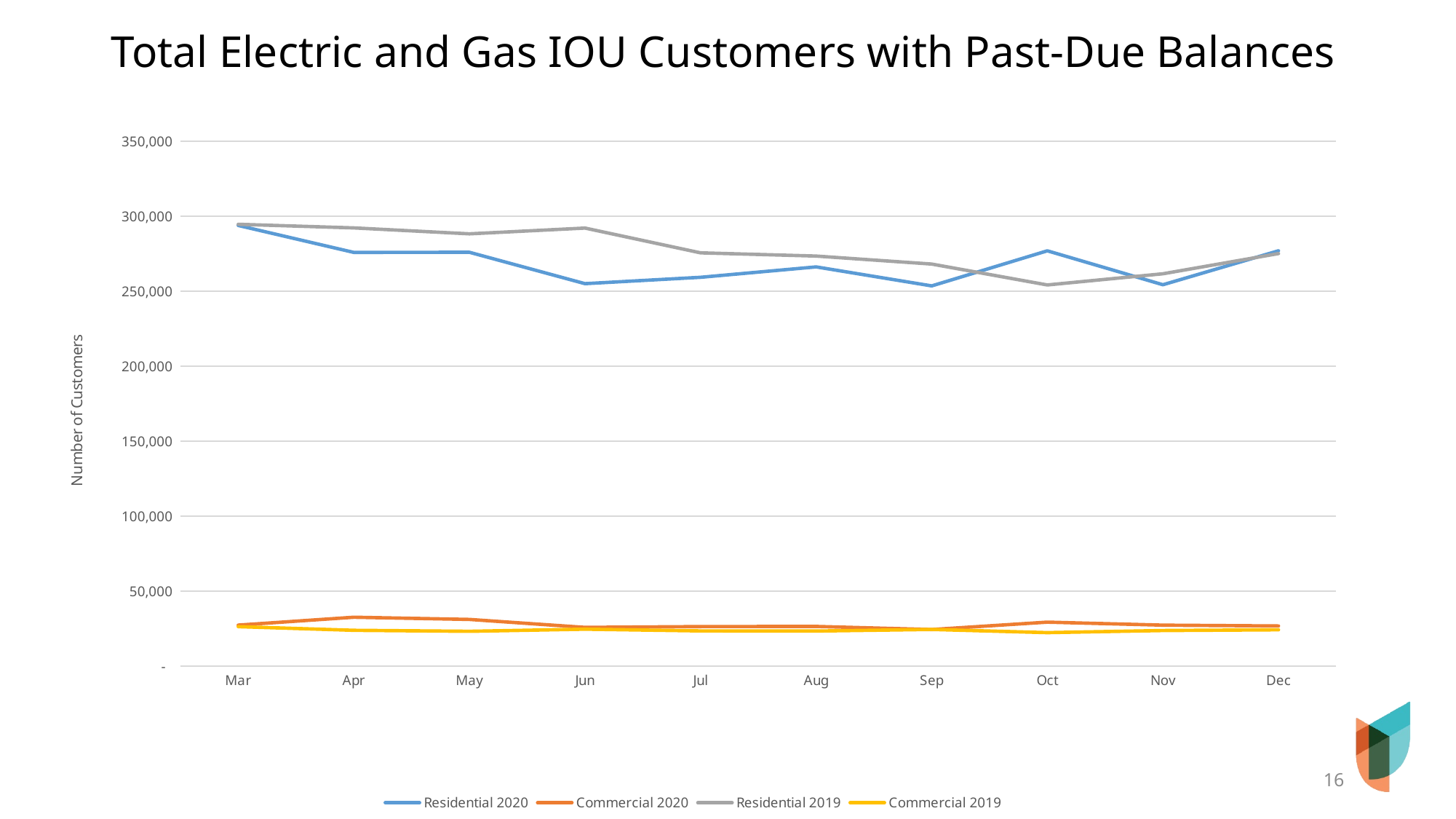
Is the value for Residential 2020 in Mar greater or less than 250,000? greater How many months are shown along the x axis? 10 In which month is Residential 2019 at its lowest? Oct How many series does the legend list? 4 Is the value for Residential 2019 in Jun greater or less than 300,000? less What kind of chart is shown on the slide? line chart In which month is Residential 2020 at its highest? Mar What is the label on the vertical axis? Number of Customers Is the value for Commercial 2020 in Apr greater or less than 50,000? less In Oct, which is larger: Residential 2020 or Residential 2019? Residential 2020 In Jun, which is larger: Residential 2019 or Residential 2020? Residential 2019 Does the Residential 2019 line rise or fall overall from Mar to Oct? fall